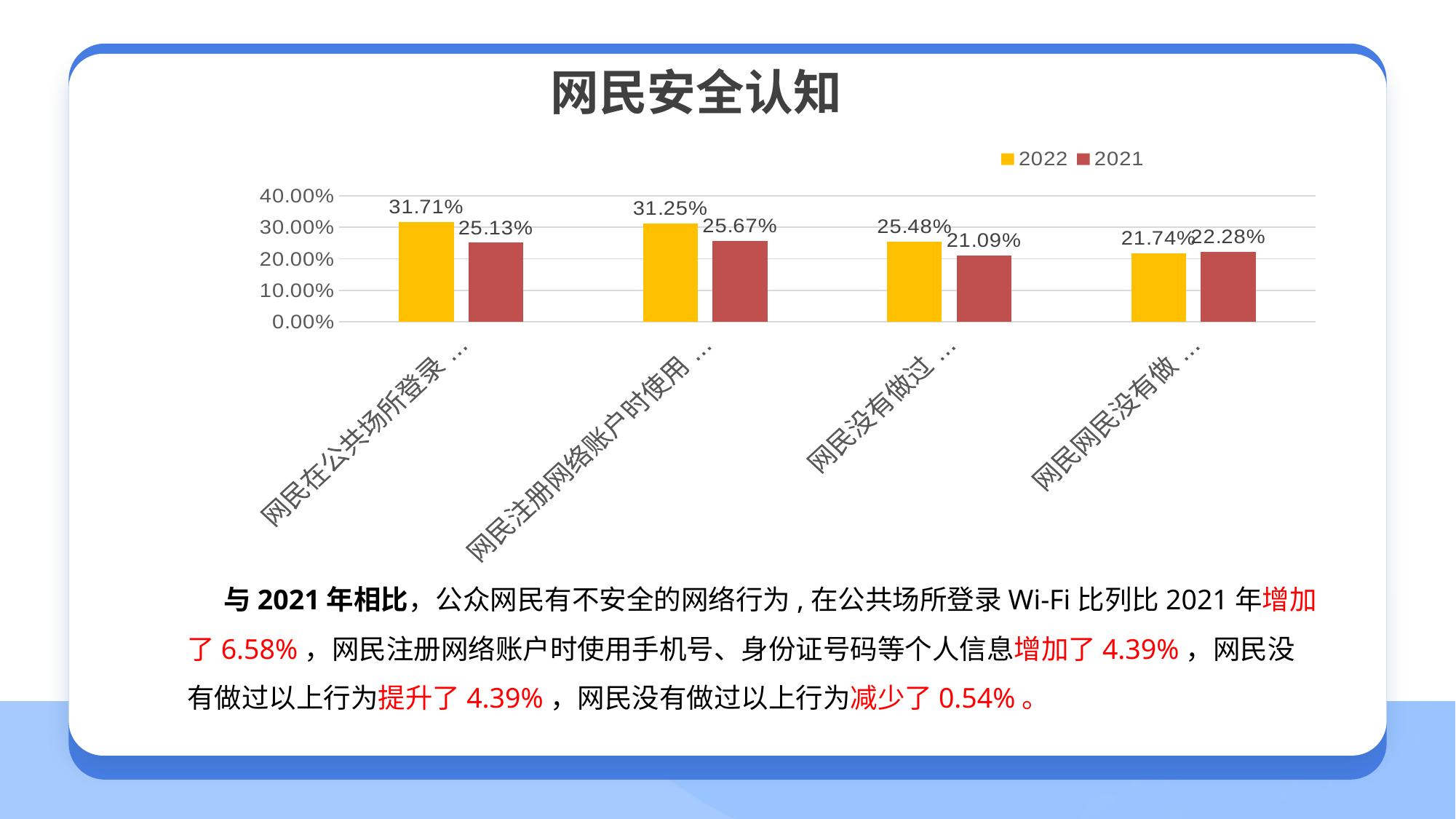
How many series does the chart legend list? 2 What is the 2021 value for the second category (网民注册网络账户时使用…)? 25.67% What is the difference between the 2022 and 2021 values for the third category (网民没有做过…)? 4.39% What is the difference between the 2022 and 2021 values for the first category (网民在公共场所登录…)? 6.58% Which category has the highest 2022 value? 网民在公共场所登录… (the first category) What is the 2022 value for the first category (网民在公共场所登录…)? 31.71% How many categories are plotted along the x axis of the chart? 4 What kind of chart is shown on the slide? bar chart Which category has the lowest 2021 value? 网民没有做过… (the third category) Which colour represents the 2022 series in the chart? yellow What is the 2021 value for the fourth category (网民网民没有做…)? 22.28% For the fourth category (网民网民没有做…), which is larger, the 2022 value or the 2021 value? 2021